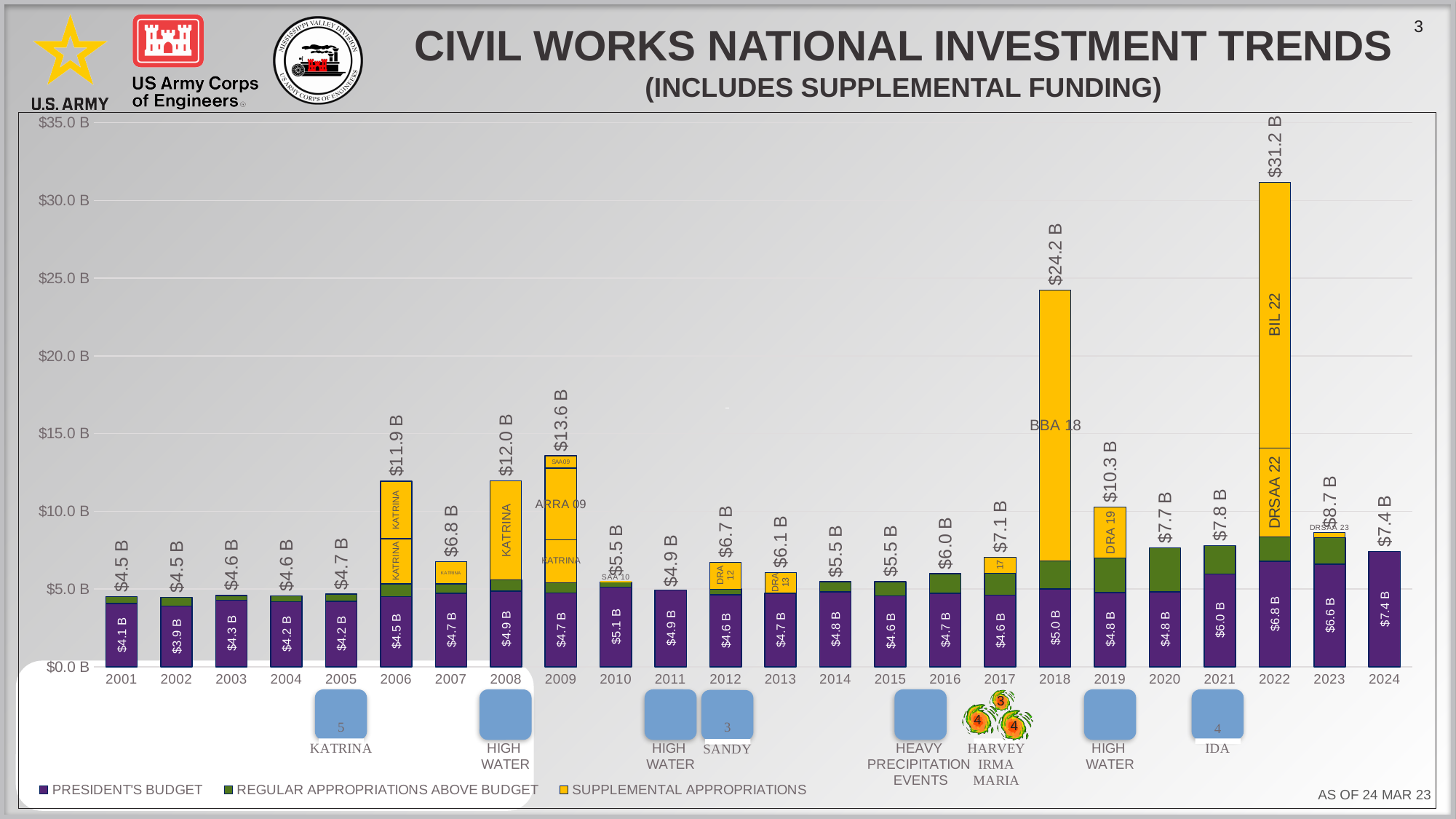
Which year has the lowest President's Budget value? 2002 Which year has the highest total bar? 2022 What label is printed on the large supplemental appropriations segment of the 2022 bar? BIL 22 What is the difference between the total for 2022 and the total for 2018? $7.0 B How many series does the legend list? 3 Is the total for 2019 greater or less than $10.0 B? greater What is the total value shown for 2022? $31.2 B Which year has the larger total, 2006 or 2008? 2008 Do the total values rise or fall from 2001 to 2005? rise What kind of chart is shown on the slide? Stacked bar chart What is the President's Budget value shown for 2002? $3.9 B How many years are shown on the x axis? 24